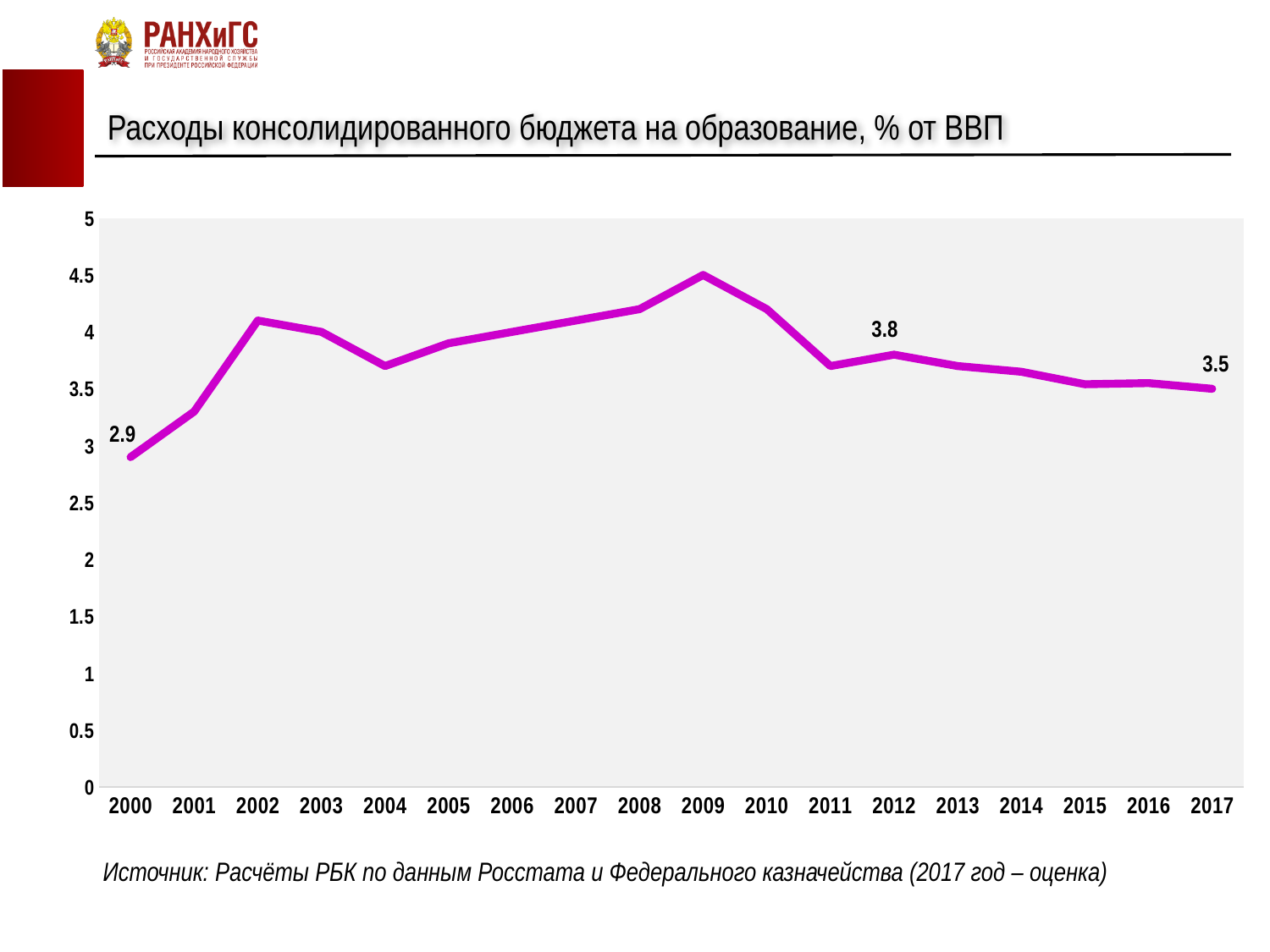
How many years are plotted on the x axis? 18 What kind of chart is shown on the slide? line chart What is the difference between the values for 2017 and 2000? 0.6 What is the value for 2012? 3.8 What is the value for 2017? 3.5 Which year has the lowest value? 2000 Is the value for 2009 greater or less than 4? greater What is the difference between the values for 2012 and 2017? 0.3 Which is larger, the value for 2012 or the value for 2017? 2012 Is the value for 2004 greater or less than 4? less What is the value for 2000? 2.9 Which year has the highest value? 2009